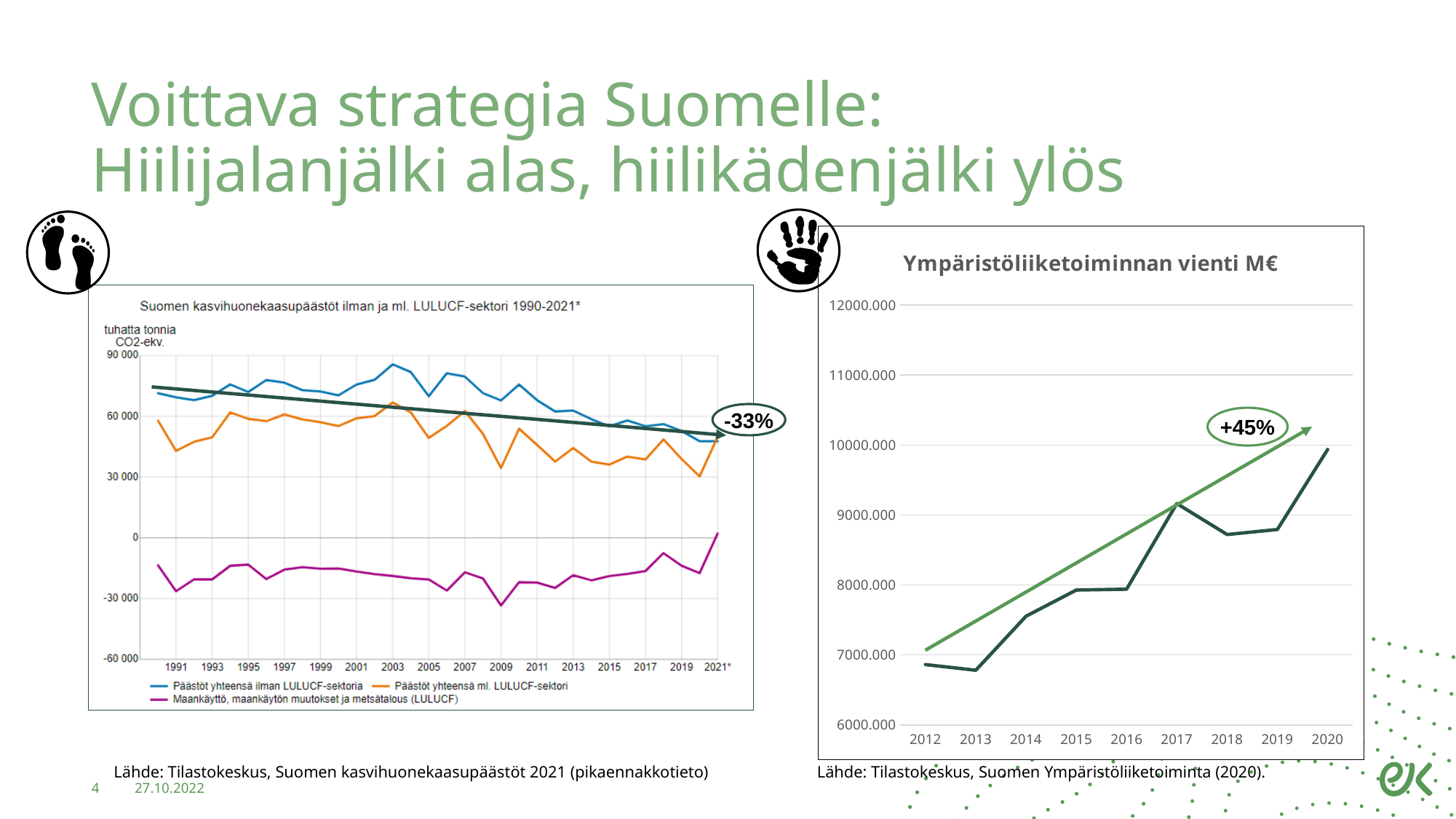
In the left-hand emissions chart, does the series "Päästöt yhteensä ilman LULUCF-sektoria" generally rise or fall from 2003 to 2021*? fall In the right-hand chart "Ympäristöliiketoiminnan vienti M€", which is larger, the value for 2017 or the value for 2018? 2017 In the right-hand chart "Ympäristöliiketoiminnan vienti M€", is the value for 2020 greater or less than 9000.000? greater In the left-hand emissions chart, which series is higher in 2003: "Päästöt yhteensä ilman LULUCF-sektoria" or "Päästöt yhteensä ml. LULUCF-sektori"? Päästöt yhteensä ilman LULUCF-sektoria In the right-hand chart "Ympäristöliiketoiminnan vienti M€", which year has the highest value? 2020 In the left-hand emissions chart, is the value of the LULUCF series (Maankäyttö, maankäytön muutokset ja metsätalous) in 2009 greater or less than -30 000? less In the right-hand chart "Ympäristöliiketoiminnan vienti M€", is the value for 2012 greater or less than 7000.000? less What percentage change is annotated on the trend arrow in the left-hand emissions chart? -33% How many years are shown on the x axis of the right-hand chart "Ympäristöliiketoiminnan vienti M€"? 9 What kind of chart is the right-hand chart titled "Ympäristöliiketoiminnan vienti M€"? line chart In the right-hand chart "Ympäristöliiketoiminnan vienti M€", do the values generally rise or fall from 2012 to 2020? rise How many series does the legend of the left-hand emissions chart list? 3